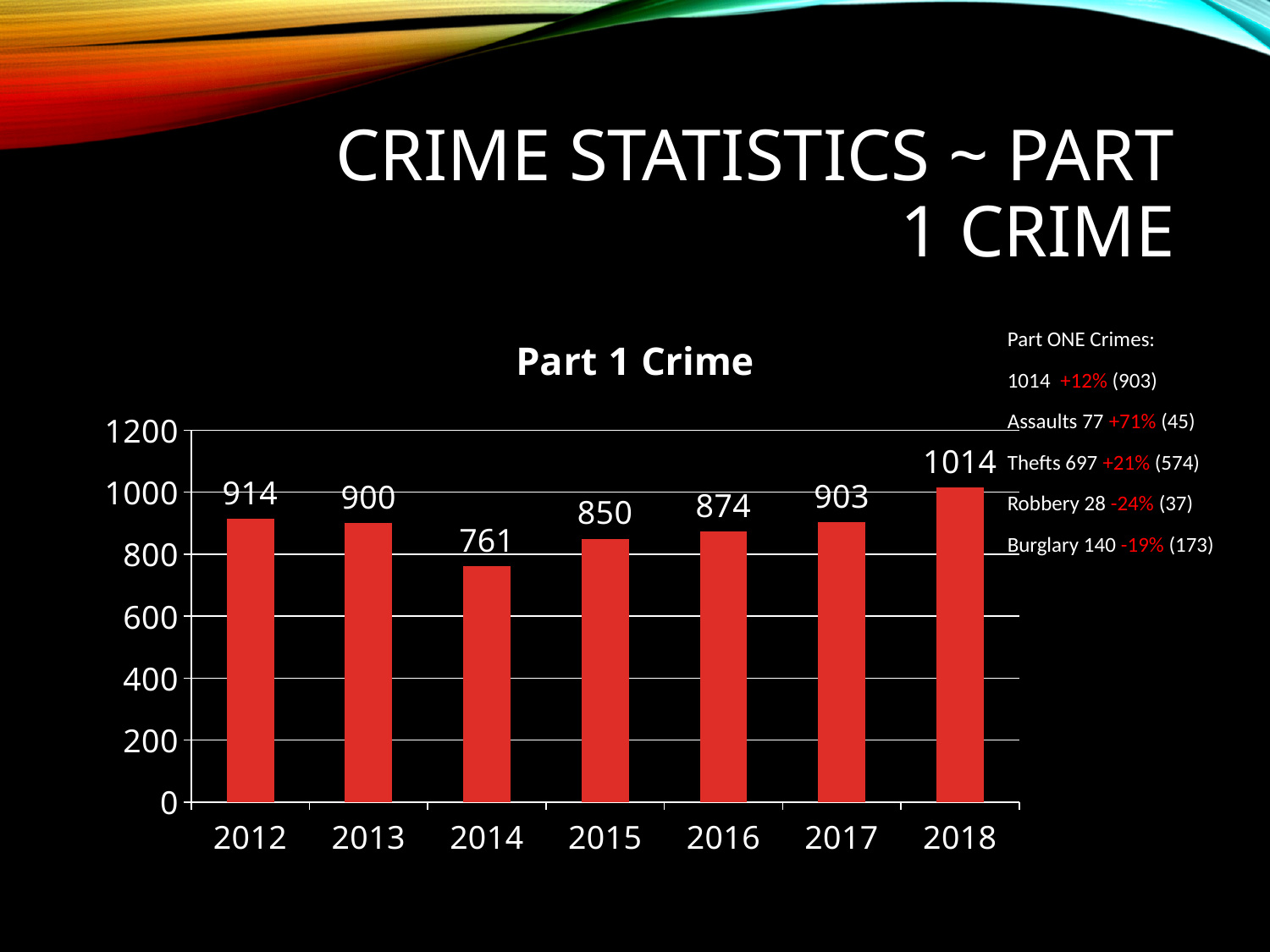
Which is larger, the value for 2015 or the value for 2016? 2016 How many years are shown on the x axis? 7 What is the difference between the values for 2012 and 2014? 153 What is the difference between the values for 2018 and 2017? 111 What is the value for 2018? 1014 Which year has the lowest value? 2014 Is the value for 2018 greater or less than 1000? greater What is the value for 2014? 761 What is the title of the chart? Part 1 Crime What is the value for 2016? 874 Which year has the highest value? 2018 What kind of chart is this? bar chart